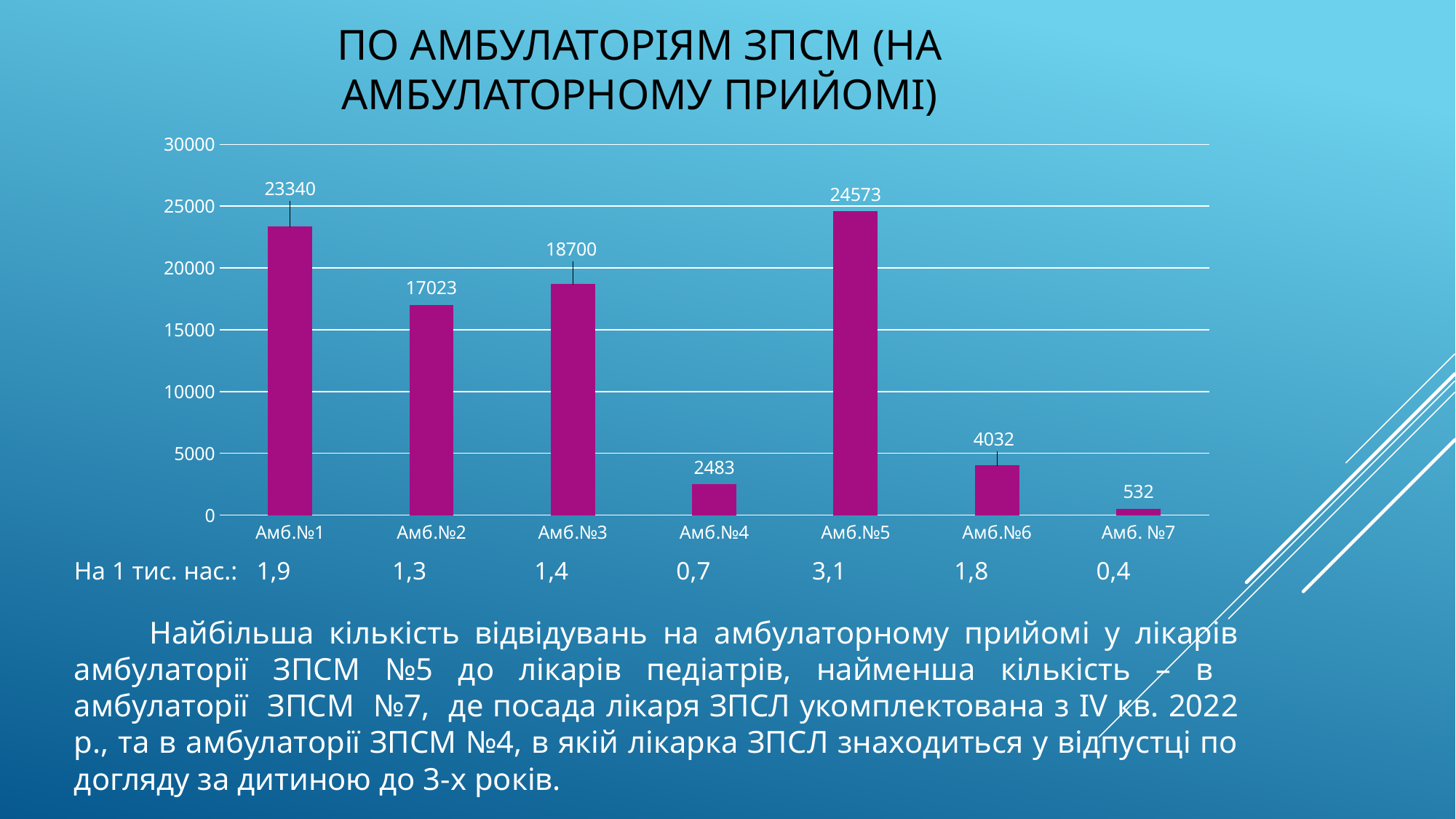
What is the title of the chart? ПО АМБУЛАТОРІЯМ ЗПСМ (НА АМБУЛАТОРНОМУ ПРИЙОМІ) What is the difference between the values for Амб.№5 and Амб.№1? 1233 Which category has the lowest value? Амб. №7 Which category has the highest value? Амб.№5 What value is shown for Амб.№5? 24573 Is the value for Амб.№4 greater or less than 5000? less Which is larger, the value for Амб.№2 or the value for Амб.№3? Амб.№3 What is the difference between the values for Амб.№3 and Амб.№2? 1677 How many categories are shown on the x axis? 7 What kind of chart is shown on the slide? bar chart What value is shown for Амб.№6? 4032 What value is shown for Амб.№1? 23340